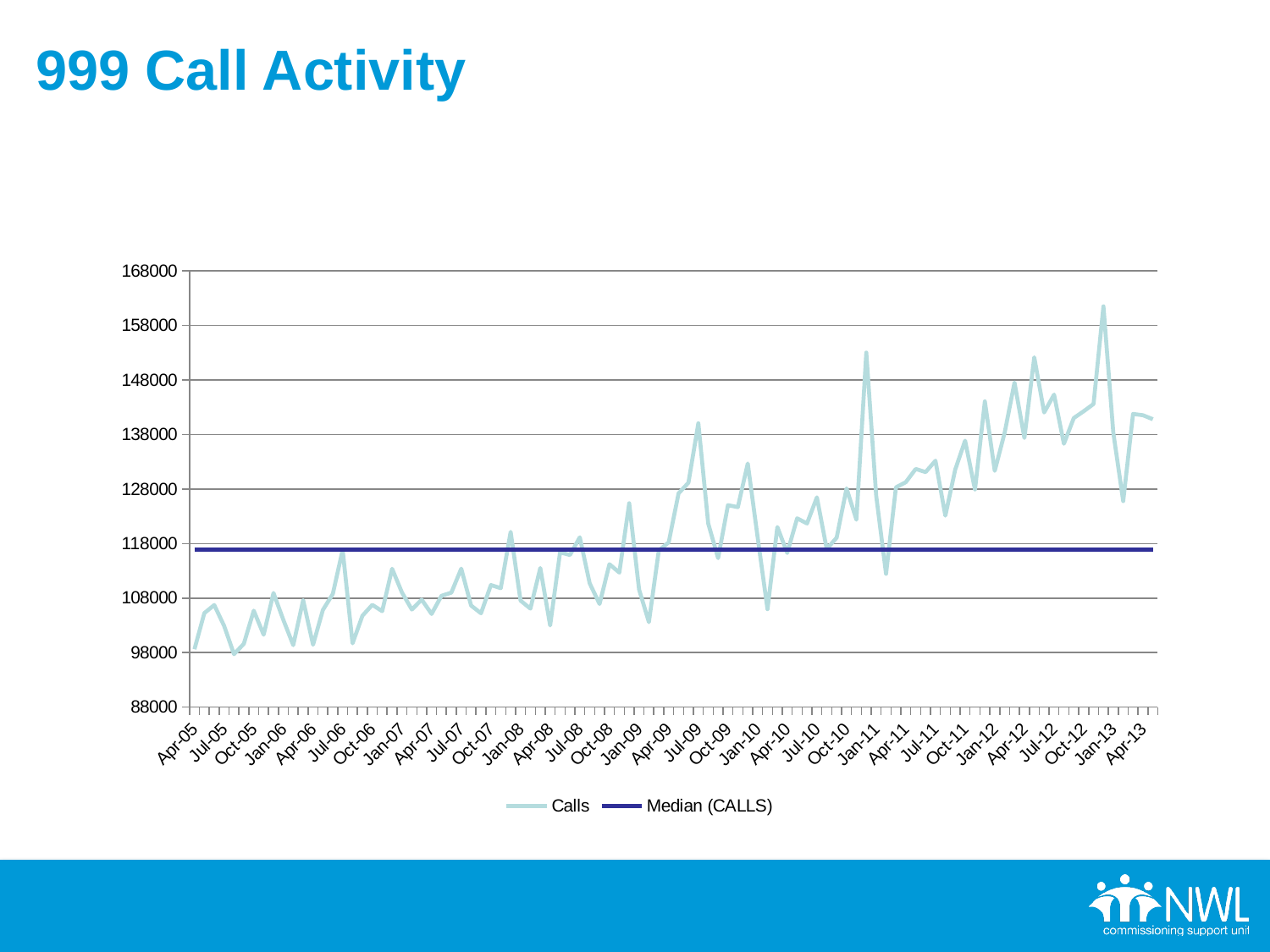
Overall, do the Calls values rise or fall from Apr-05 to Apr-13? rise Is the Calls value for Apr-13 greater or less than 128000? greater Is the Calls value for Apr-05 greater or less than 108000? less Which is larger, the Calls value for Jul-09 or the Calls value for Jul-05? Jul-09 Is the Median (CALLS) line greater or less than 108000? greater What kind of chart is shown on the slide? line chart Which is larger, the Calls value for Apr-13 or the Calls value for Apr-05? Apr-13 What is the highest value shown on the vertical axis? 168000 How many series does the legend list? 2 What are the two series named in the legend? Calls and Median (CALLS) What is the title of the slide containing the chart? 999 Call Activity